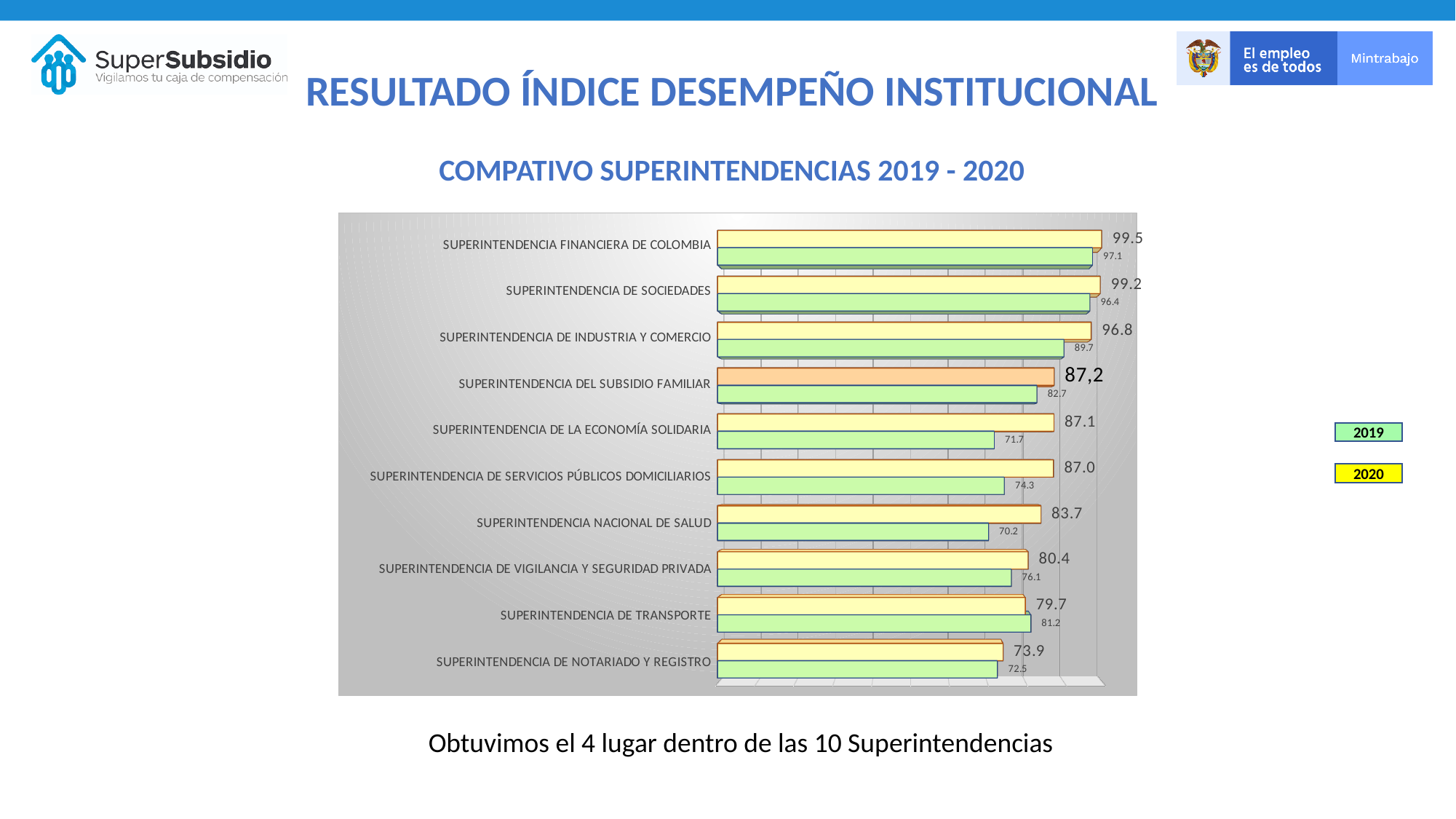
How many superintendencias are listed as categories in the chart? 10 For Superintendencia de Transporte, which is larger: the 2019 value or the 2020 value? 2019 What is the 2019 value for Superintendencia de Industria y Comercio? 89.7 Which superintendencia has the highest 2019 value? Superintendencia Financiera de Colombia What is the 2020 value for Superintendencia Financiera de Colombia? 99.5 What is the 2019 value for Superintendencia Nacional de Salud? 70.2 Which superintendencia has the lowest 2020 value? Superintendencia de Notariado y Registro What kind of chart is shown on the slide? bar chart What is the 2020 value for Superintendencia del Subsidio Familiar? 87,2 Which colour represents the 2020 series in the legend? yellow How many series does the legend list? 2 What is the difference between the 2020 and 2019 values for Superintendencia de la Economía Solidaria? 15.4